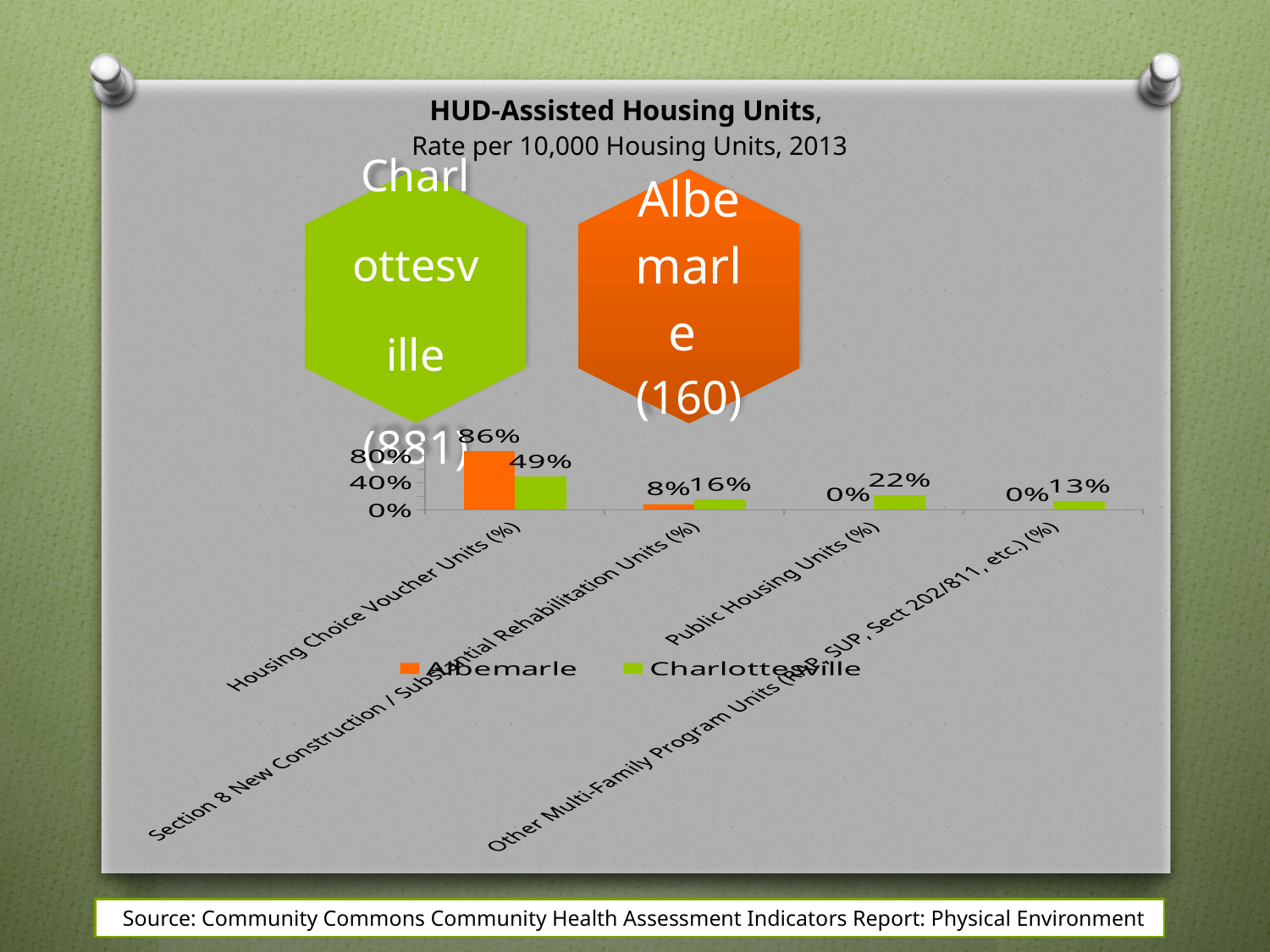
What is the value for Albemarle for Other Multi-Family Program Units (RAP, SUP, Sect 202/811, etc.) (%)? 0% Which colour represents Albemarle in the chart? Orange Which category has the highest value for Charlottesville? Housing Choice Voucher Units (%) How many categories are shown on the x axis of the chart? 4 How many series does the chart legend list? 2 What is the value for Charlottesville for Section 8 New Construction / Substantial Rehabilitation Units (%)? 16% Which category has the lowest value for Charlottesville? Other Multi-Family Program Units (RAP, SUP, Sect 202/811, etc.) (%) What kind of chart is shown on the slide? Bar chart Which is larger for Public Housing Units (%): Albemarle or Charlottesville? Charlottesville What is the difference between Albemarle and Charlottesville for Housing Choice Voucher Units (%)? 37% What is the value for Charlottesville for Public Housing Units (%)? 22% What is the value for Albemarle for Housing Choice Voucher Units (%)? 86%